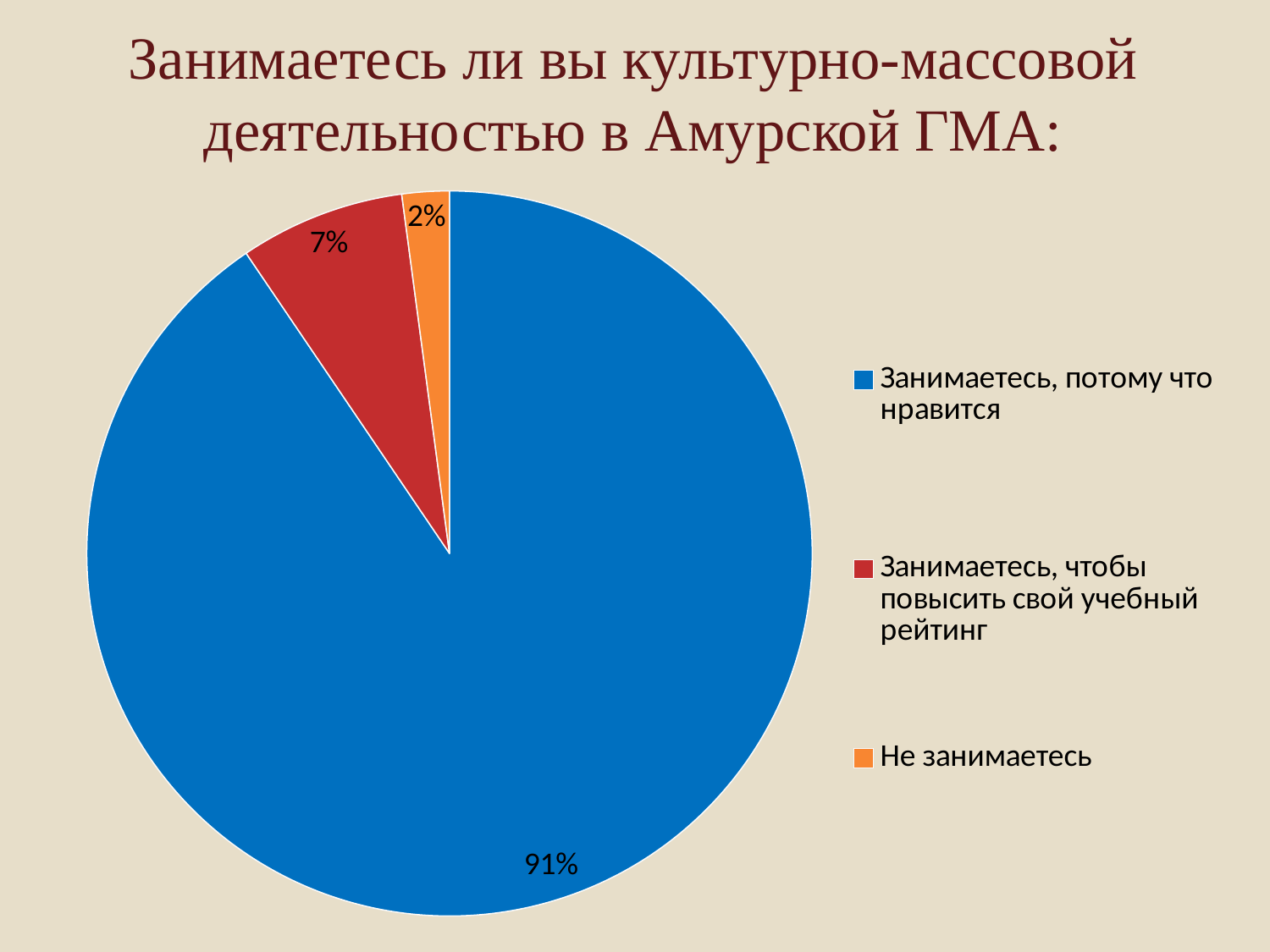
What kind of chart is shown on the slide? Pie chart What is the difference in percentage points between the "Занимаетесь, чтобы повысить свой учебный рейтинг" slice and the "Не занимаетесь" slice? 5% What is the title of the slide? Занимаетесь ли вы культурно-массовой деятельностью в Амурской ГМА: What share of the pie does the slice "Занимаетесь, чтобы повысить свой учебный рейтинг" represent? 7% What share of the pie does the slice "Занимаетесь, потому что нравится" represent? 91% How many categories are shown in the pie chart? 3 Which category has the smallest slice of the pie? Не занимаетесь What colour is the slice for "Не занимаетесь"? Orange Which is larger: the slice for "Занимаетесь, чтобы повысить свой учебный рейтинг" or the slice for "Не занимаетесь"? Занимаетесь, чтобы повысить свой учебный рейтинг Which category has the largest slice of the pie? Занимаетесь, потому что нравится What share of the pie does the slice "Не занимаетесь" represent? 2%